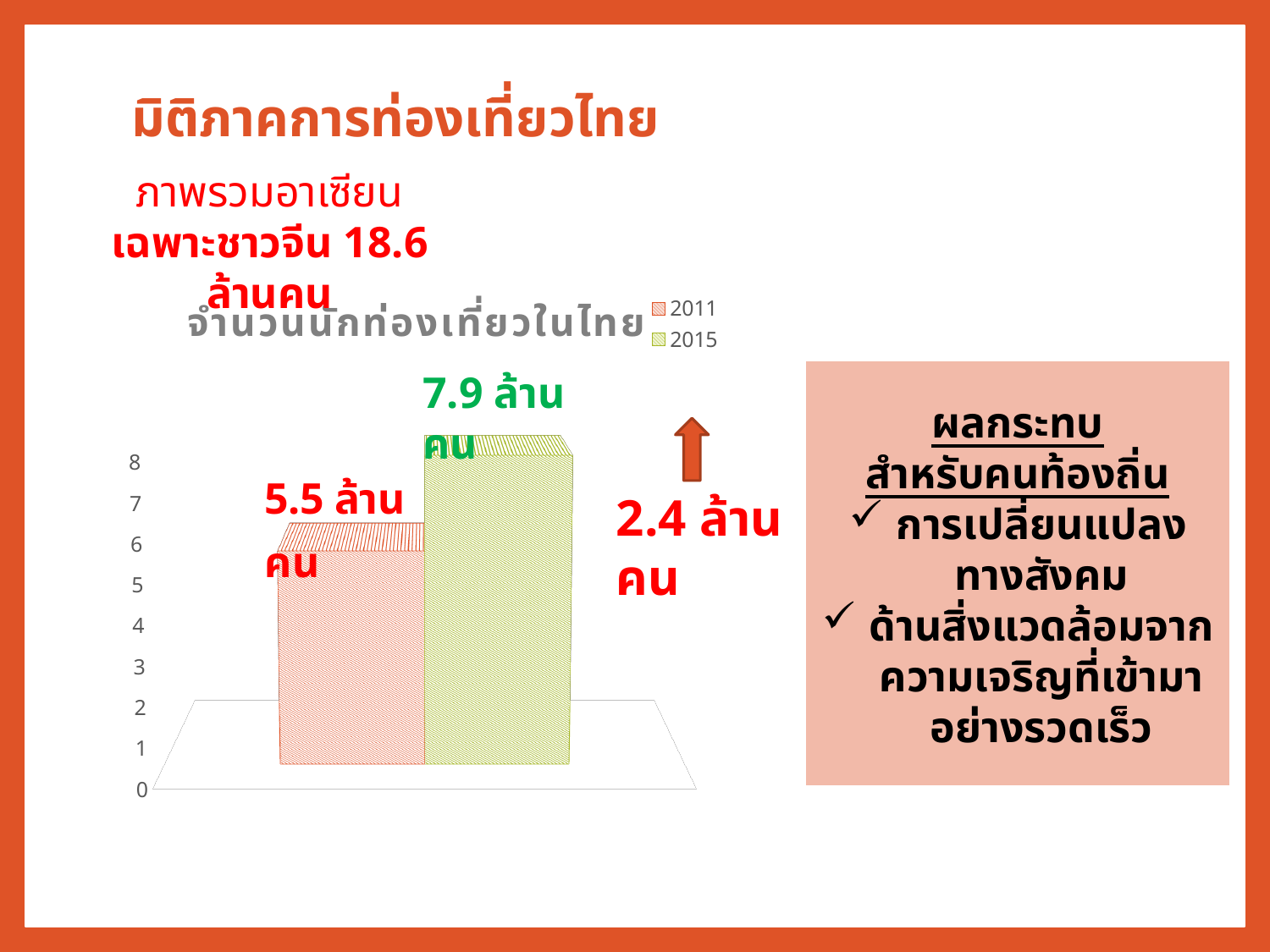
What is the difference between the 2015 and 2011 values? 2.4 ล้านคน How many series does the chart legend list? 2 What type of chart is shown on the slide? bar chart How many bars are plotted in the chart? 2 Is the value for 2015 greater or less than 7? greater Is the value for 2011 greater or less than 6? less Do the values rise or fall from 2011 to 2015? rise What value is labelled for the 2011 bar? 5.5 ล้านคน Which year has the higher number of tourists, 2011 or 2015? 2015 What is the title of the chart? จำนวนนักท่องเที่ยวในไทย Which series has the lowest value in the chart? 2011 What value is labelled for the 2015 bar? 7.9 ล้านคน